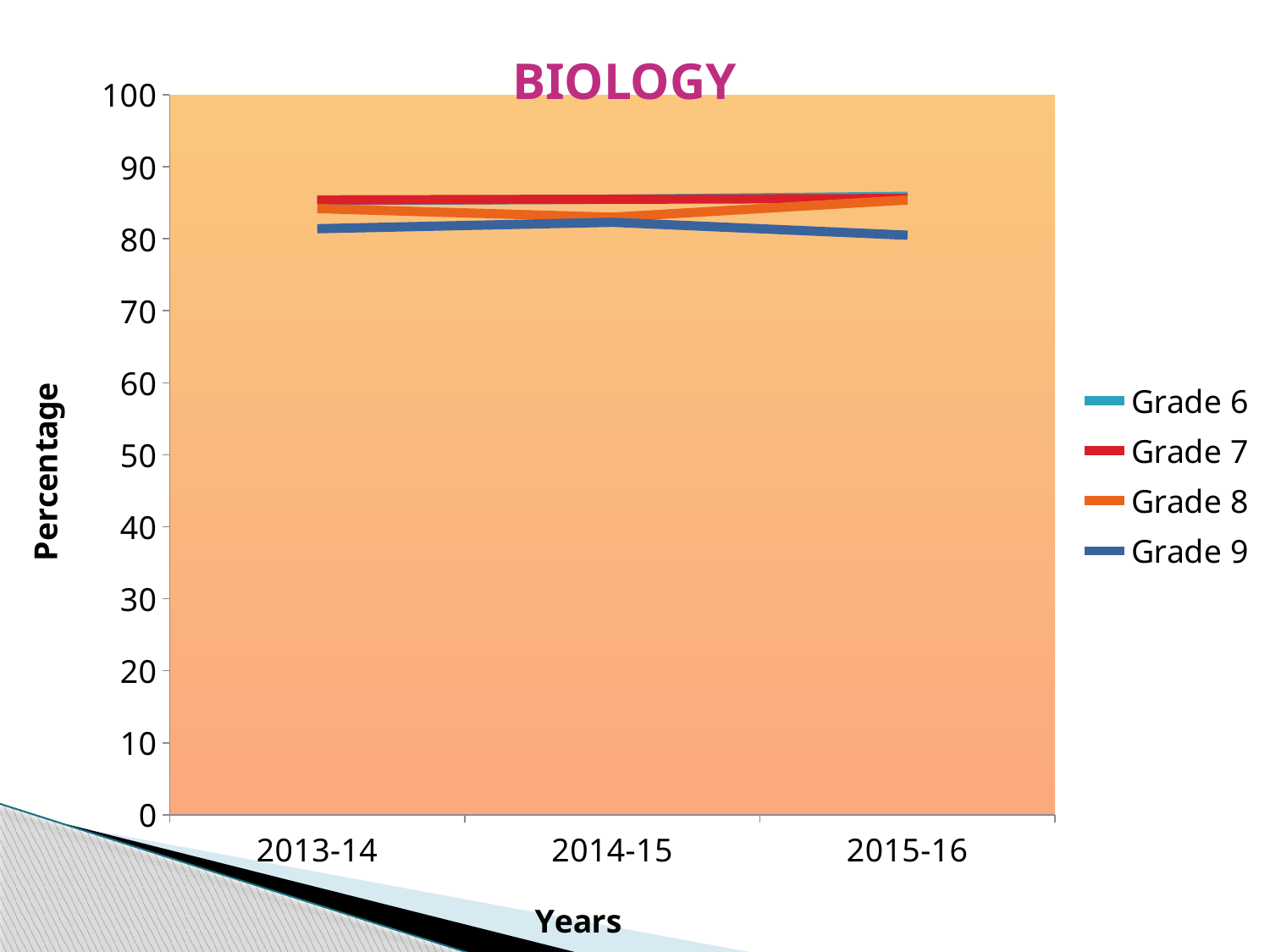
Is the value for Grade 9 in 2015-16 greater or less than 90? less Does the Grade 8 line rise or fall from 2014-15 to 2015-16? rise What kind of chart is shown on the slide? line chart What is the title of the chart? BIOLOGY Is the value for Grade 7 in 2013-14 greater or less than 80? greater How many years are shown along the x axis? 3 Which is larger in 2013-14, the value for Grade 7 or the value for Grade 9? Grade 7 Which grade has the lowest value in 2015-16? Grade 9 What is the label of the vertical axis? Percentage How many series does the legend list? 4 Is the value for Grade 9 in 2013-14 greater or less than 70? greater Does the Grade 9 line rise or fall from 2014-15 to 2015-16? fall